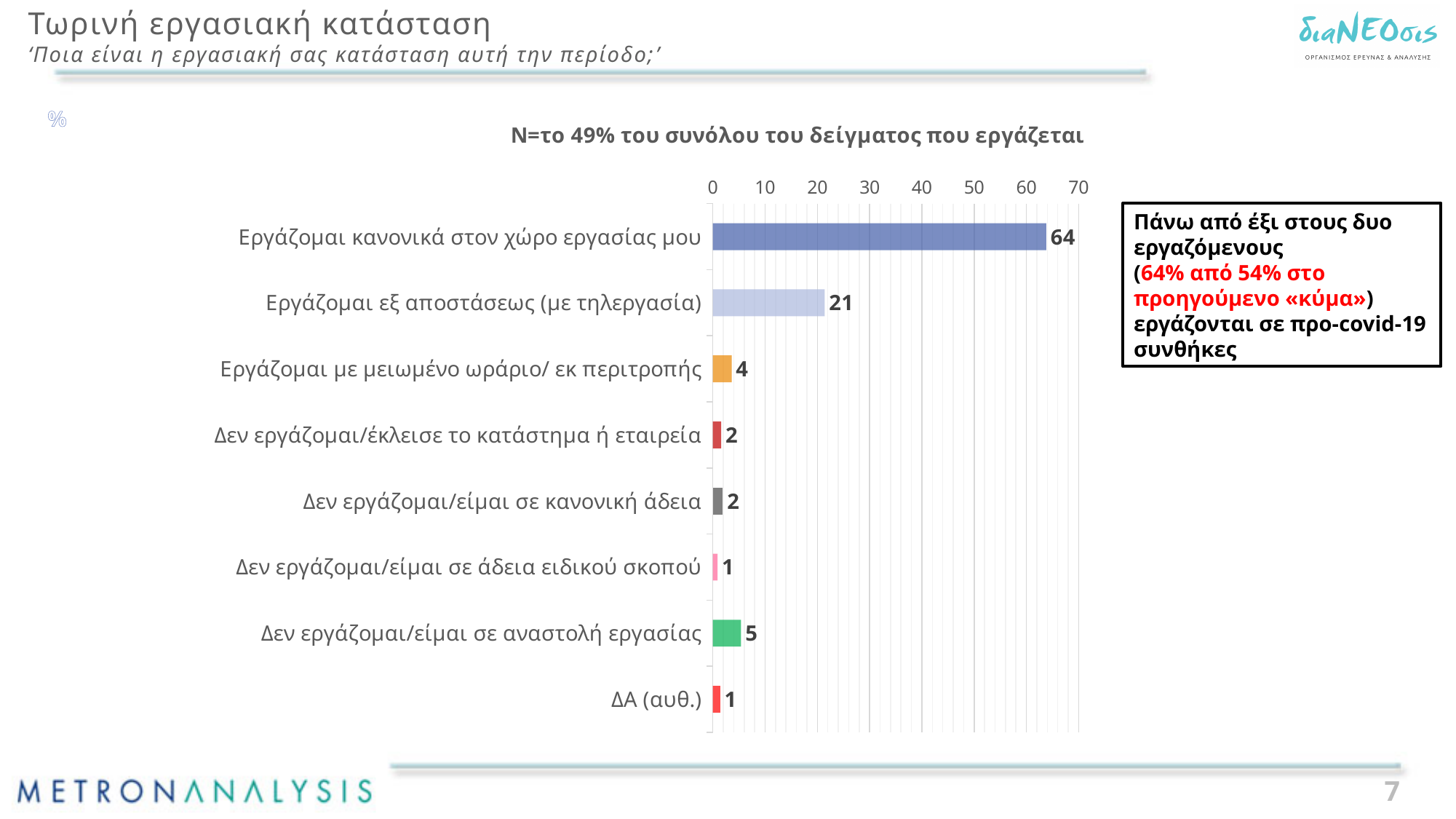
What is the heading printed above the chart? N=το 49% του συνόλου του δείγματος που εργάζεται What is the value for 'Εργάζομαι με μειωμένο ωράριο/ εκ περιτροπής'? 4 What is the value for 'Εργάζομαι εξ αποστάσεως (με τηλεργασία)'? 21 What is the difference between the values for 'Εργάζομαι κανονικά στον χώρο εργασίας μου' and 'Εργάζομαι εξ αποστάσεως (με τηλεργασία)'? 43 What is the value for 'ΔΑ (αυθ.)'? 1 How many categories are shown in the chart? 8 Which is larger: the value for 'Δεν εργάζομαι/είμαι σε αναστολή εργασίας' or the value for 'Εργάζομαι με μειωμένο ωράριο/ εκ περιτροπής'? Δεν εργάζομαι/είμαι σε αναστολή εργασίας Is the value for 'Εργάζομαι κανονικά στον χώρο εργασίας μου' greater or less than 60? greater What is the value for 'Εργάζομαι κανονικά στον χώρο εργασίας μου'? 64 Which category has the highest value? Εργάζομαι κανονικά στον χώρο εργασίας μου What is the value for 'Δεν εργάζομαι/είμαι σε αναστολή εργασίας'? 5 What kind of chart is shown on the slide? bar chart